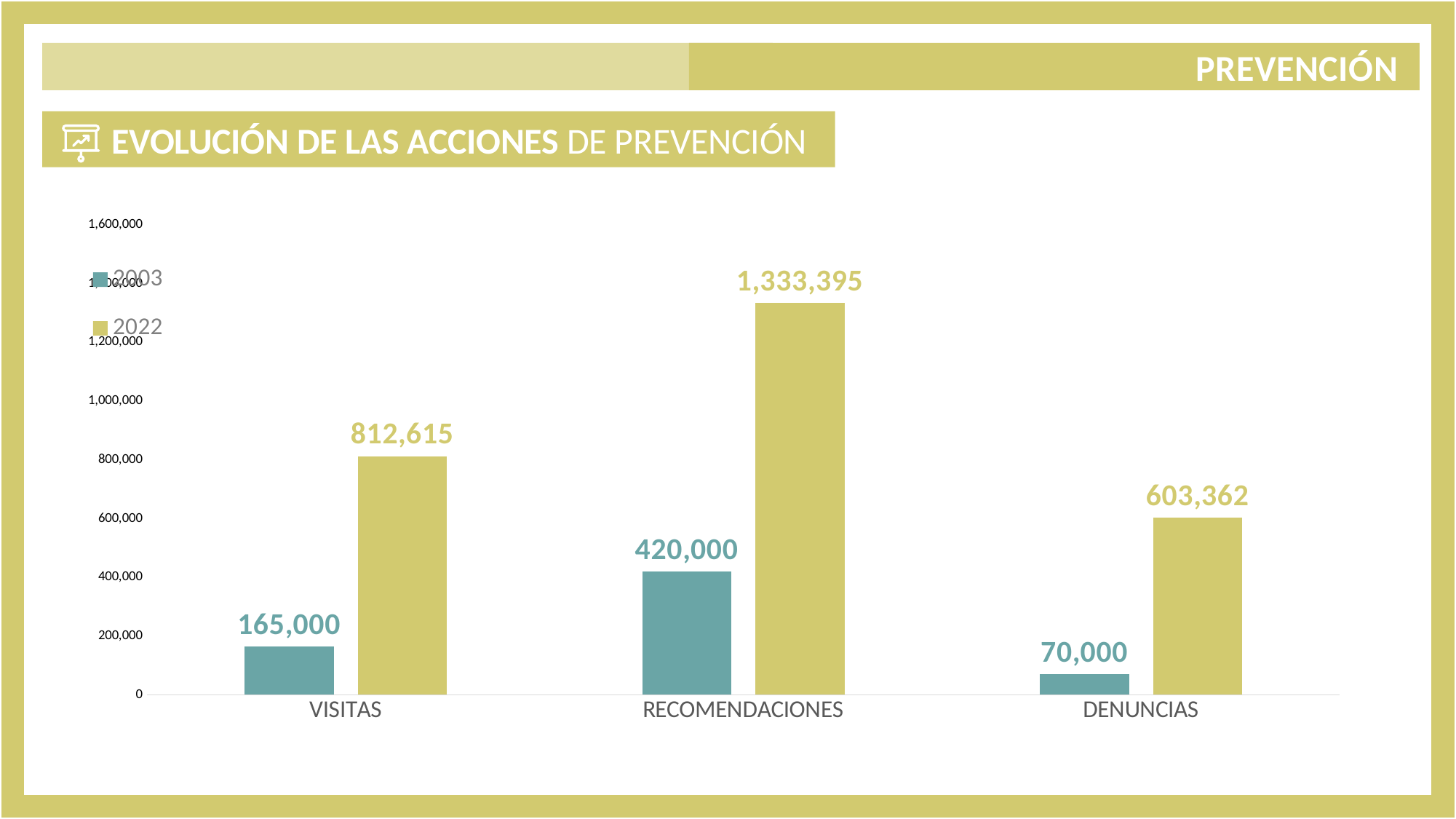
What is the value for RECOMENDACIONES in 2003? 420,000 What is the value for DENUNCIAS in 2003? 70,000 Which category has the highest value in 2022? RECOMENDACIONES Which is larger: the 2003 value for RECOMENDACIONES or the 2022 value for DENUNCIAS? 2022 value for DENUNCIAS How many categories are shown on the x axis? 3 What is the difference between the 2022 and 2003 values for VISITAS? 647,615 What is the value for VISITAS in 2022? 812,615 What kind of chart is shown on the slide? Bar chart What is the value for DENUNCIAS in 2022? 603,362 What is the difference between the 2022 and 2003 values for RECOMENDACIONES? 913,395 Which category has the lowest value in 2003? DENUNCIAS How many series does the legend list? 2